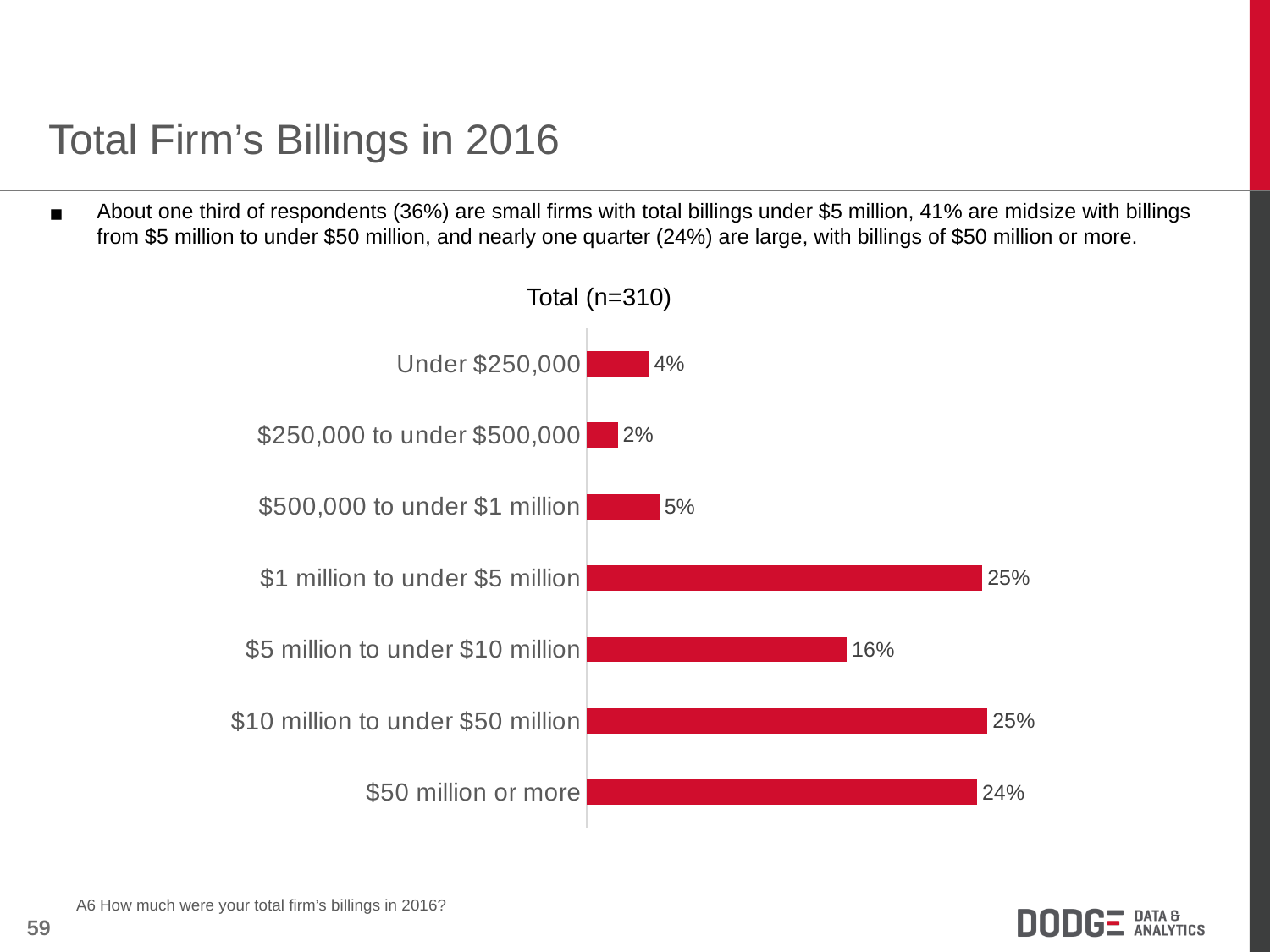
What colour are the bars in the chart? Red What type of chart is shown on the slide? Bar chart What percentage of firms had billings under $250,000? 4% How many billings categories are shown in the chart? 7 What percentage of firms had total billings of $50 million or more? 24% Which billings category has the lowest percentage? $250,000 to under $500,000 What is the difference between the $1 million to under $5 million category and the $5 million to under $10 million category? 9 percentage points What is the combined percentage of the $10 million to under $50 million and $50 million or more categories? 49% Which is larger: the value for $500,000 to under $1 million or the value for Under $250,000? $500,000 to under $1 million What is the sample size shown in the chart title? n=310 What is the difference between the $50 million or more category and the $250,000 to under $500,000 category? 22 percentage points What is the value for the $5 million to under $10 million category? 16%